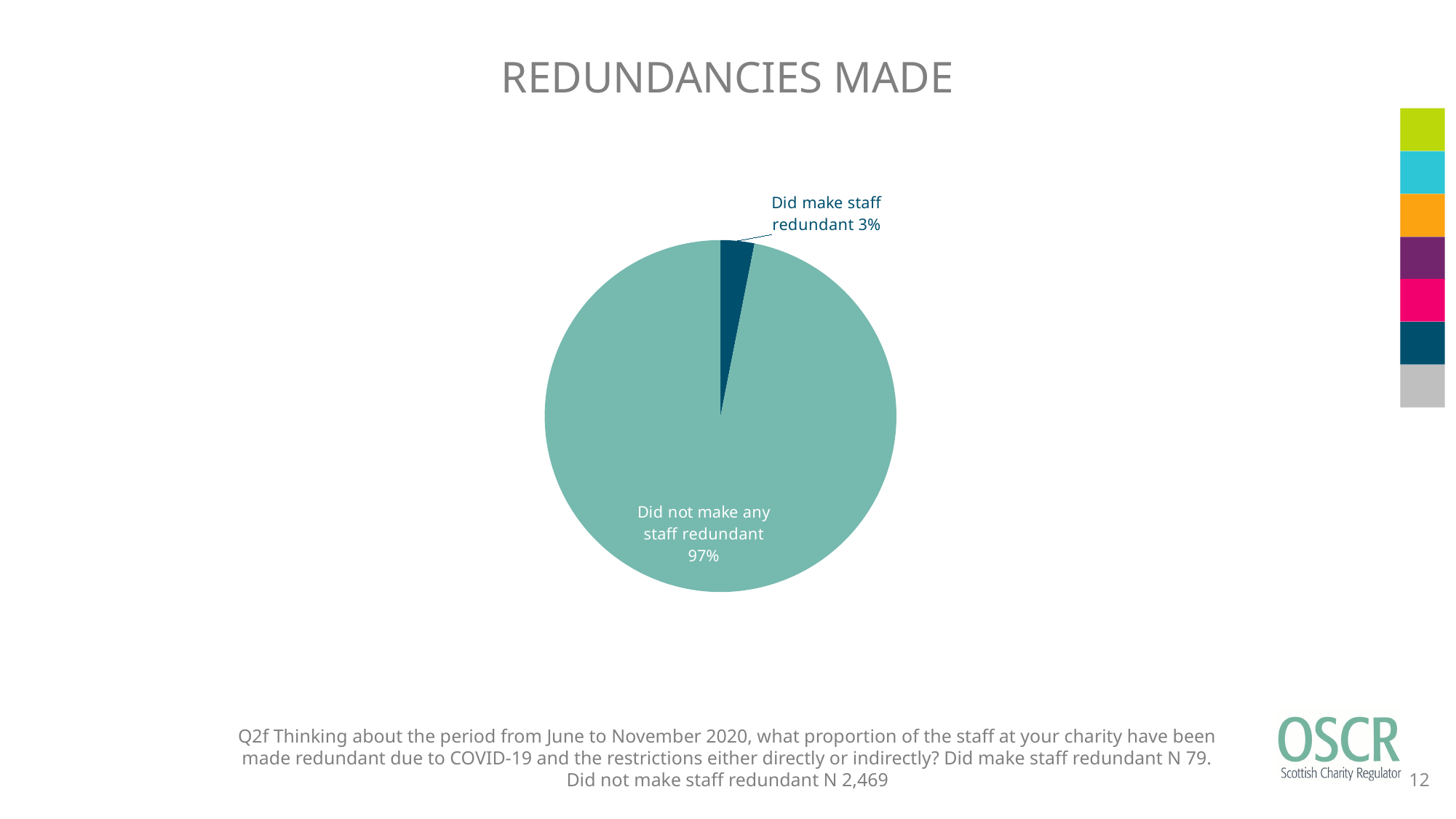
What is the difference in percentage points between the 'Did not make any staff redundant' and 'Did make staff redundant' slices? 94 Which category has the largest share of the pie? Did not make any staff redundant What percentage of charities did not make any staff redundant? 97% What is the total of the two percentages shown on the pie chart? 100% What kind of chart is shown on the slide? pie chart Which category has the smallest share of the pie? Did make staff redundant How many slices does the pie chart have? 2 What colour is the 'Did make staff redundant' slice? dark blue What percentage of charities did make staff redundant? 3% What is the title of the chart on the slide? REDUNDANCIES MADE Which is larger: the share that did make staff redundant or the share that did not make any staff redundant? Did not make any staff redundant